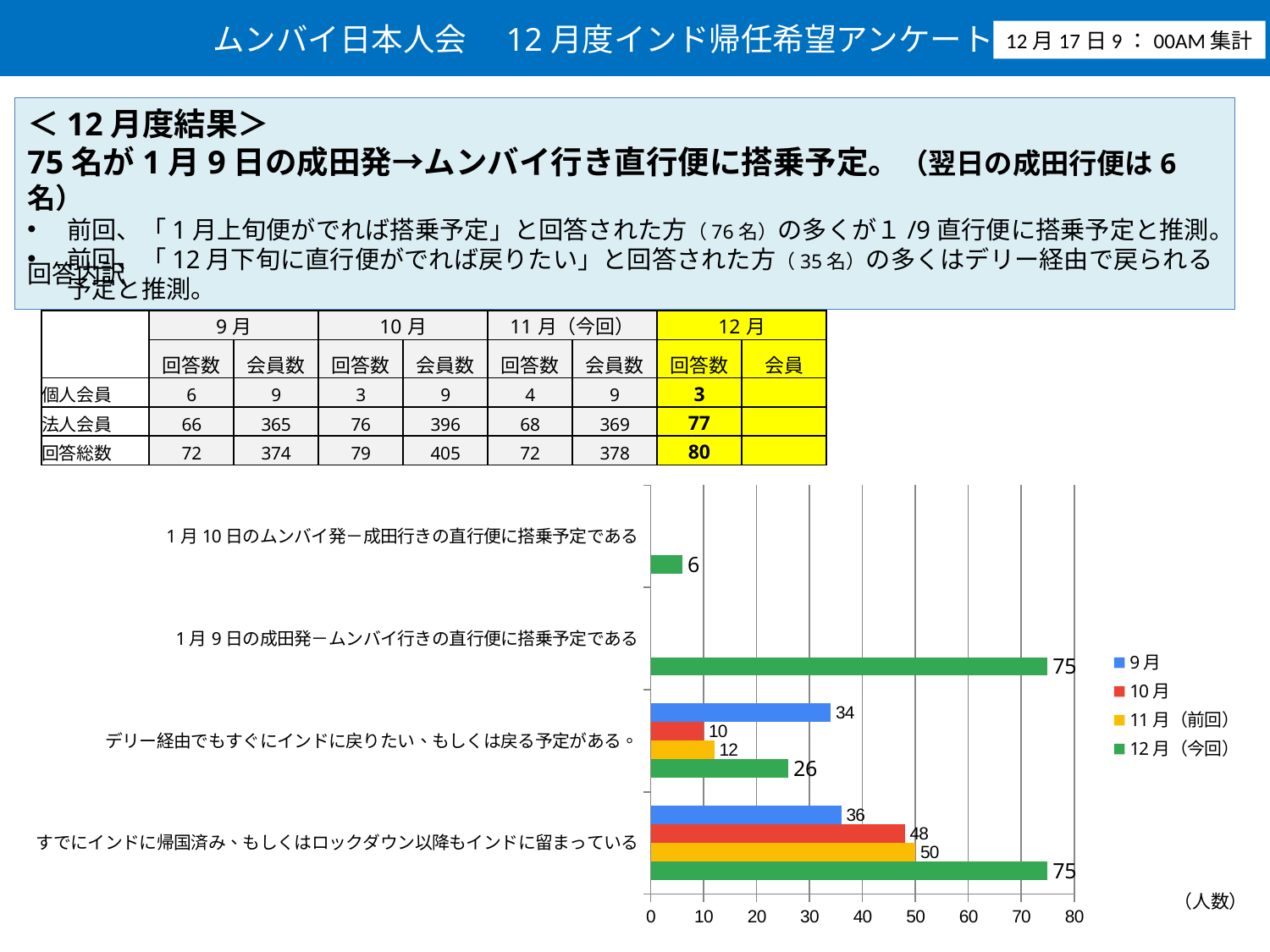
What is the 11月（前回） value for 「すでにインドに帰国済み、もしくはロックダウン以降もインドに留まっている」? 50 What is the 9月 value for 「デリー経由でもすぐにインドに戻りたい、もしくは戻る予定がある。」? 34 What colour are the 12月（今回） bars in the chart? green What kind of chart is shown on the slide? bar chart How many series does the chart legend list? 4 What is the difference between the 12月（今回） and 11月（前回） values for 「すでにインドに帰国済み、もしくはロックダウン以降もインドに留まっている」? 25 What is the 12月（今回） value for 「1月9日の成田発－ムンバイ行きの直行便に搭乗予定である」? 75 Which series has the lowest value for 「デリー経由でもすぐにインドに戻りたい、もしくは戻る予定がある。」? 10月 How many categories are shown on the chart's vertical axis? 4 Which series has the highest value for 「すでにインドに帰国済み、もしくはロックダウン以降もインドに留まっている」? 12月（今回） For 「デリー経由でもすぐにインドに戻りたい、もしくは戻る予定がある。」, which is larger: the 9月 value or the 12月（今回） value? 9月 What is the 12月（今回） value for 「1月10日のムンバイ発－成田行きの直行便に搭乗予定である」? 6